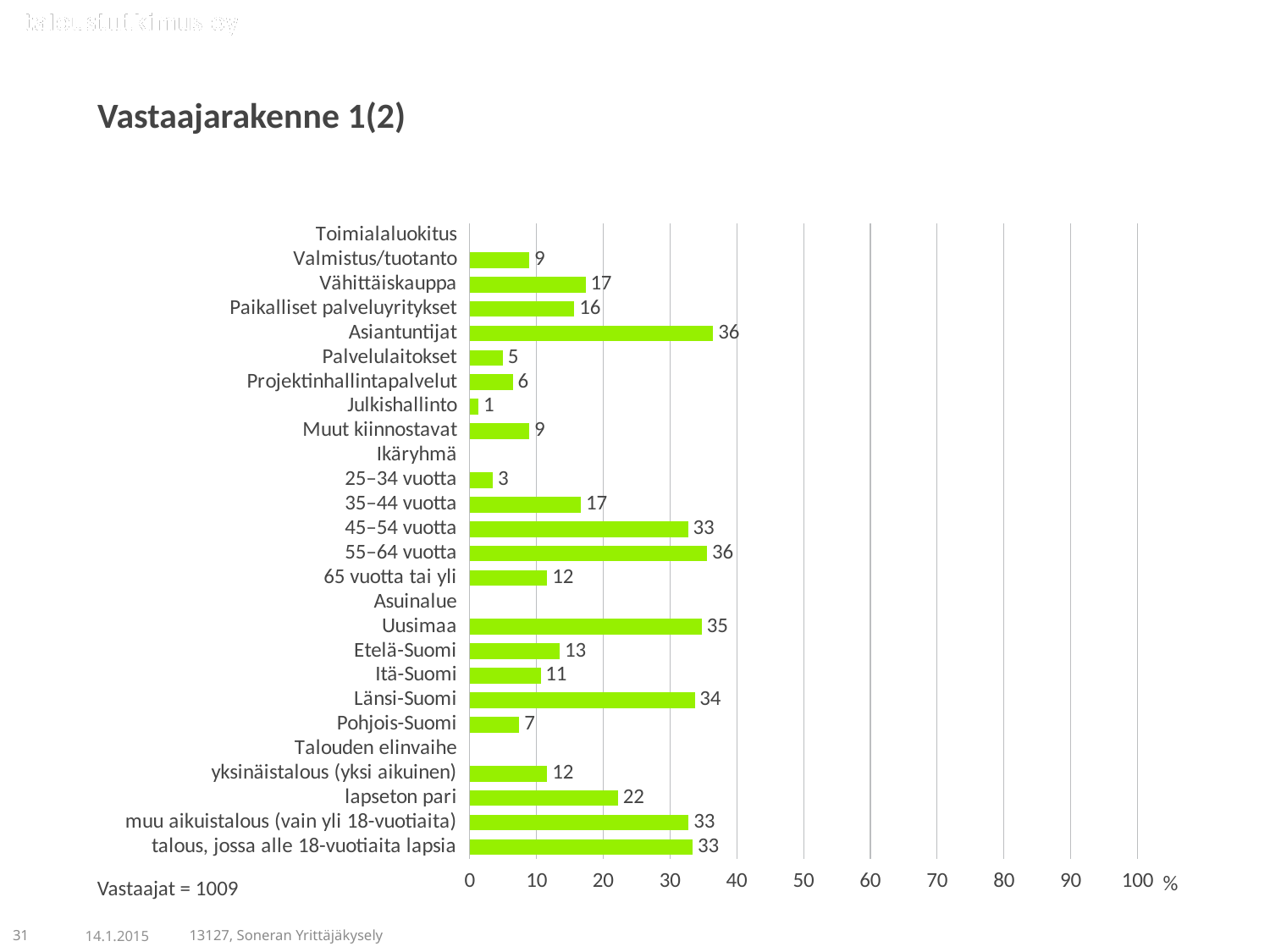
Among the Ikäryhmä categories, which has the lowest value? 25–34 vuotta What is the difference between the values for 55–64 vuotta and 35–44 vuotta? 19 Among the Asuinalue categories, which has the highest value? Uusimaa What is the value for 65 vuotta tai yli? 12 What is the value for Asiantuntijat? 36 Which is larger, the value for Vähittäiskauppa or the value for Paikalliset palveluyritykset? Vähittäiskauppa What is the title of the slide containing the chart? Vastaajarakenne 1(2) What kind of chart is shown on the slide? bar chart What is the difference between the values for Länsi-Suomi and Pohjois-Suomi? 27 What is the value for lapseton pari? 22 Which category has the lowest value in the chart? Julkishallinto What is the value for Uusimaa? 35